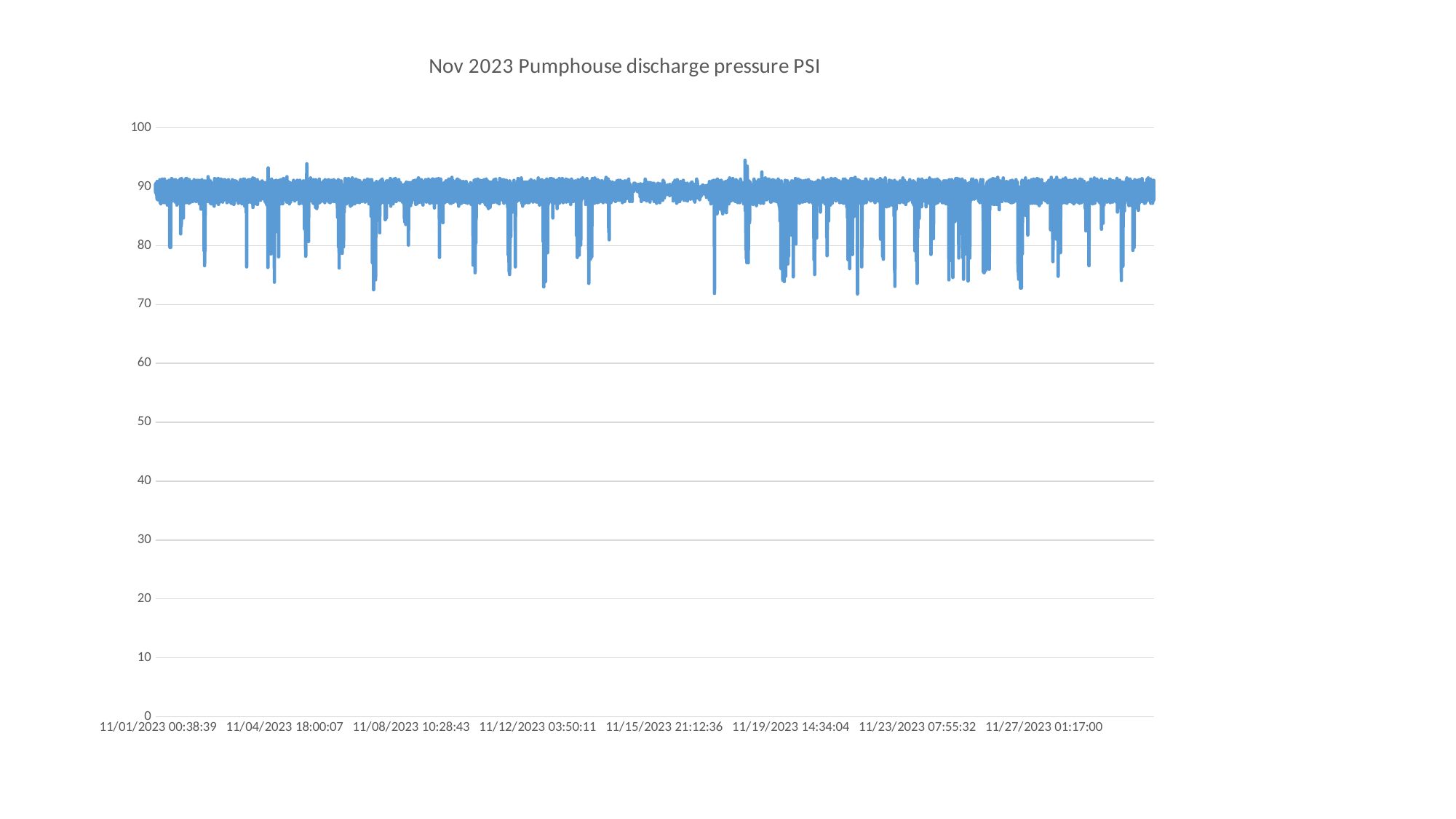
Is the pressure value at the end of the series (around 11/27/2023 01:17:00) greater or less than 60? greater What is the last date label on the horizontal axis? 11/27/2023 01:17:00 What kind of chart is shown on the slide? line chart Around which gridline value does the pressure stay for most of the month? 90 Overall, does the pressure trend strongly upward, strongly downward, or stay roughly flat across the month? roughly flat Does the plotted pressure ever drop below 60 during the month? No What is the first date label on the horizontal axis? 11/01/2023 00:38:39 How many date labels are shown along the horizontal axis? 8 What is the highest value shown on the vertical axis? 100 What is the title of the chart? Nov 2023 Pumphouse discharge pressure PSI